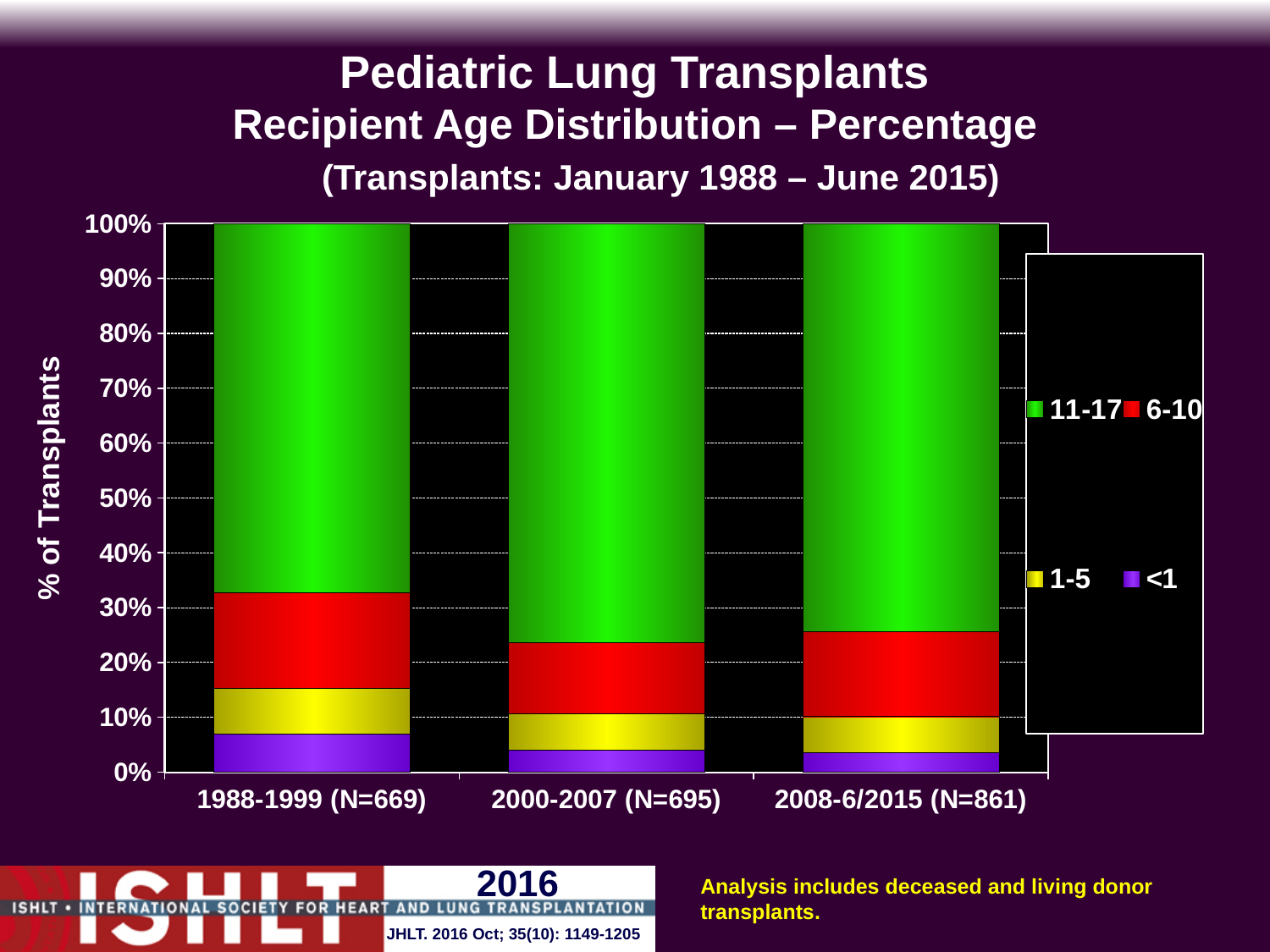
How many age groups does the legend list? 4 Is the share of recipients aged 11-17 in 1988-1999 greater or less than 70%? less Does the share of recipients aged 11-17 rise or fall from 1988-1999 to 2000-2007? rise What colour represents the 6-10 age group in the legend? Red How many time periods (bars) are shown on the x axis? 3 Which period has the largest share of recipients aged <1? 1988-1999 (N=669) Which age group makes up the largest share of transplants in every period? 11-17 What is the N shown for the 2008-6/2015 period? 861 Which period has the larger share of recipients aged 11-17: 1988-1999 or 2000-2007? 2000-2007 What kind of chart is shown on the slide? Stacked bar chart Is the share of recipients aged <1 in 1988-1999 greater or less than 10%? less Is the share of recipients aged 11-17 in 2000-2007 greater or less than 70%? greater